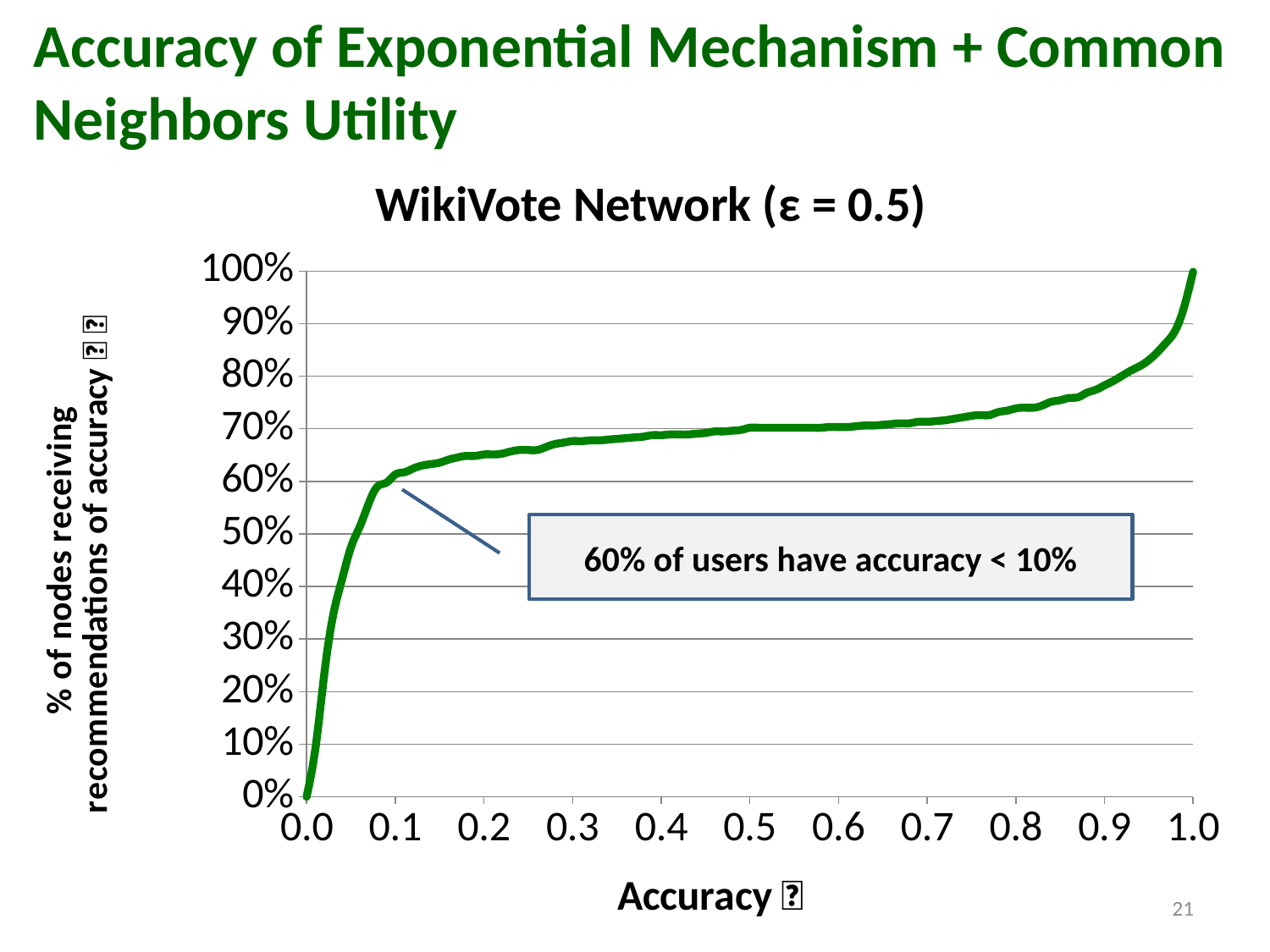
Is the value of the line at accuracy 0.9 greater or less than 70%? greater Is the value of the line at accuracy 0.5 greater or less than 60%? greater What is the value of the line at accuracy 0.0? 0% Which has the larger value on the line: accuracy 0.3 or accuracy 0.9? accuracy 0.9 Does the plotted line rise or fall as accuracy increases from 0.0 to 1.0? rises What does the annotation box on the chart say? 60% of users have accuracy < 10% Is the value of the line at accuracy 0.5 greater or less than 80%? less What kind of chart is shown on the slide? line chart At which accuracy value does the line reach its highest point? 1.0 What is the title of the chart? WikiVote Network (ε = 0.5)